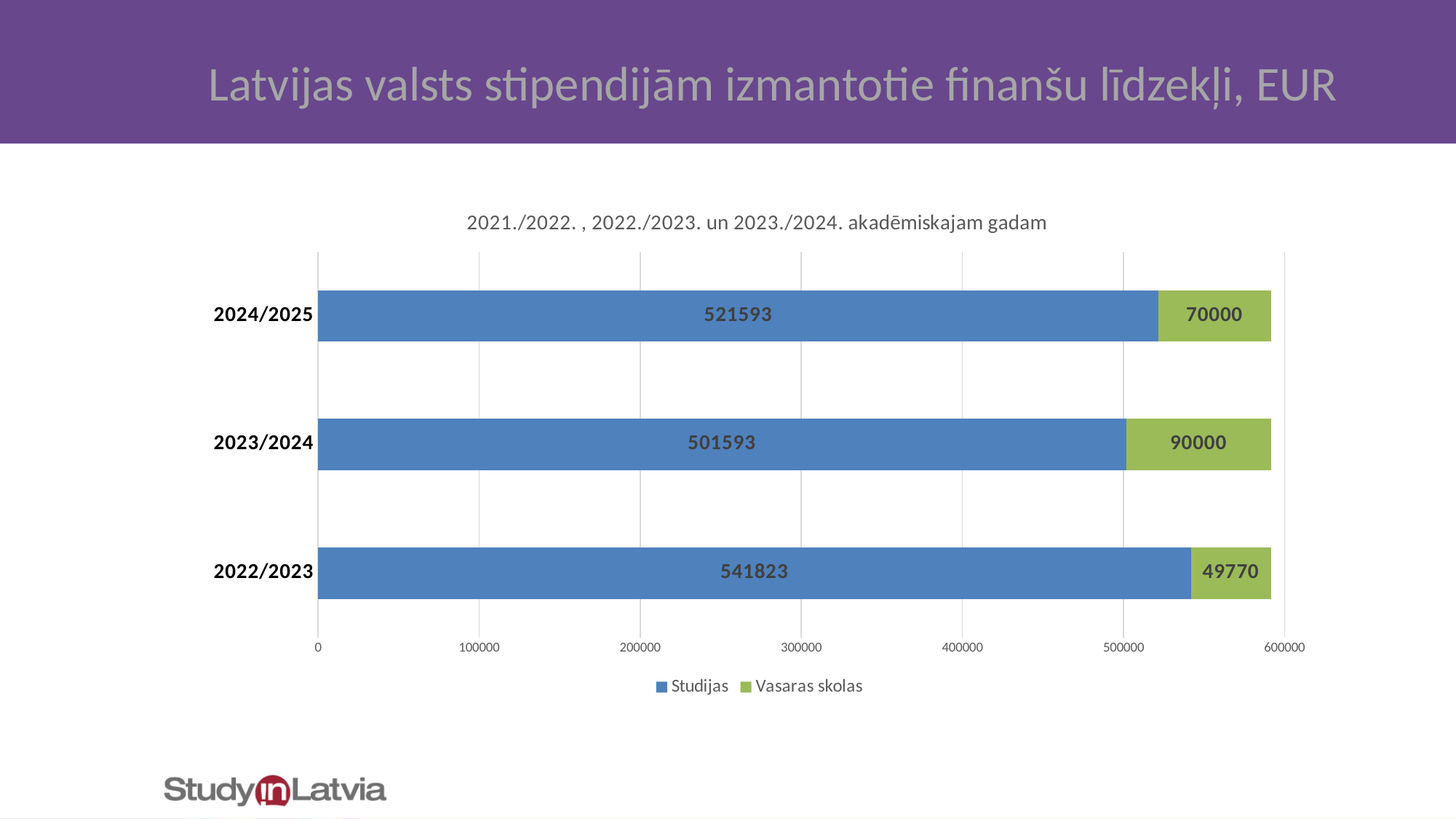
Which academic year has the highest Studijas value? 2022/2023 Is the Studijas value for 2023/2024 greater or less than 400000? greater Which academic year has the lowest Vasaras skolas value? 2022/2023 How many series does the legend list? 2 What kind of chart is shown on the slide? Stacked bar chart What is the difference between the Studijas values for 2024/2025 and 2023/2024? 20000 What is the Vasaras skolas value for 2022/2023? 49770 What is the Studijas value for 2024/2025? 521593 What is the Vasaras skolas value for 2023/2024? 90000 What is the total of the stacked bar for 2022/2023? 591593 How many academic years are shown on the chart? 3 Which is larger: the Vasaras skolas value for 2023/2024 or for 2024/2025? 2023/2024